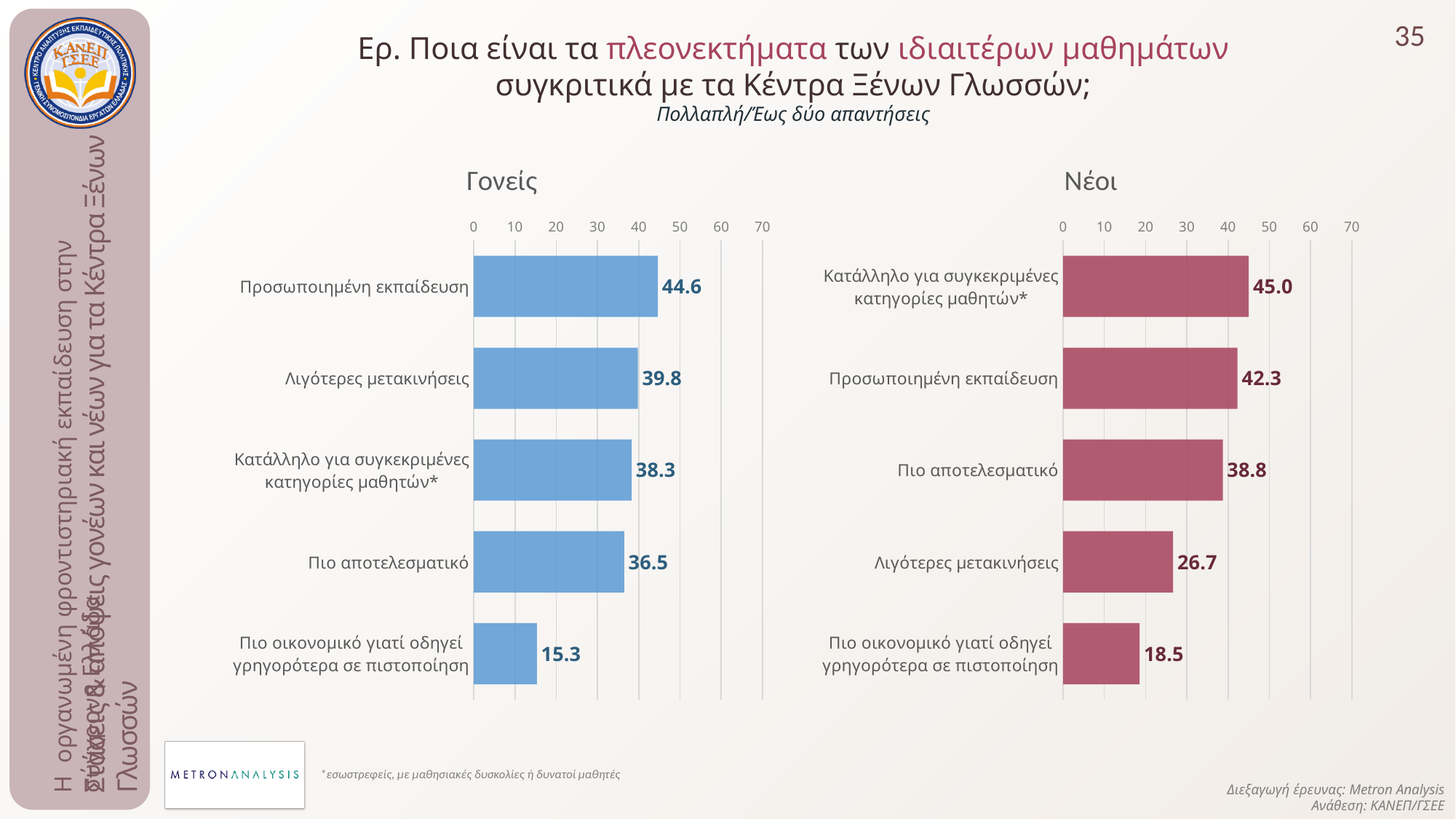
In the Νέοι chart, what is the difference between Κατάλληλο για συγκεκριμένες κατηγορίες μαθητών* and Πιο οικονομικό γιατί οδηγεί γρηγορότερα σε πιστοποίηση? 26.5 In the Γονείς chart, what is the value for Πιο αποτελεσματικό? 36.5 In the Γονείς chart, what is the value for Προσωποιημένη εκπαίδευση? 44.6 In the Γονείς chart, what is the difference between Προσωποιημένη εκπαίδευση and Λιγότερες μετακινήσεις? 4.8 How many categories does the Γονείς chart show? 5 In the Νέοι chart, is the value for Πιο αποτελεσματικό greater or less than 30? greater In the Νέοι chart, which category has the highest value? Κατάλληλο για συγκεκριμένες κατηγορίες μαθητών* What kind of chart is the Νέοι chart? bar chart In the Γονείς chart, which category has the lowest value? Πιο οικονομικό γιατί οδηγεί γρηγορότερα σε πιστοποίηση Which is larger: Λιγότερες μετακινήσεις in the Γονείς chart or Λιγότερες μετακινήσεις in the Νέοι chart? Γονείς In the Νέοι chart, what is the value for Λιγότερες μετακινήσεις? 26.7 What colour are the bars in the Νέοι chart? red